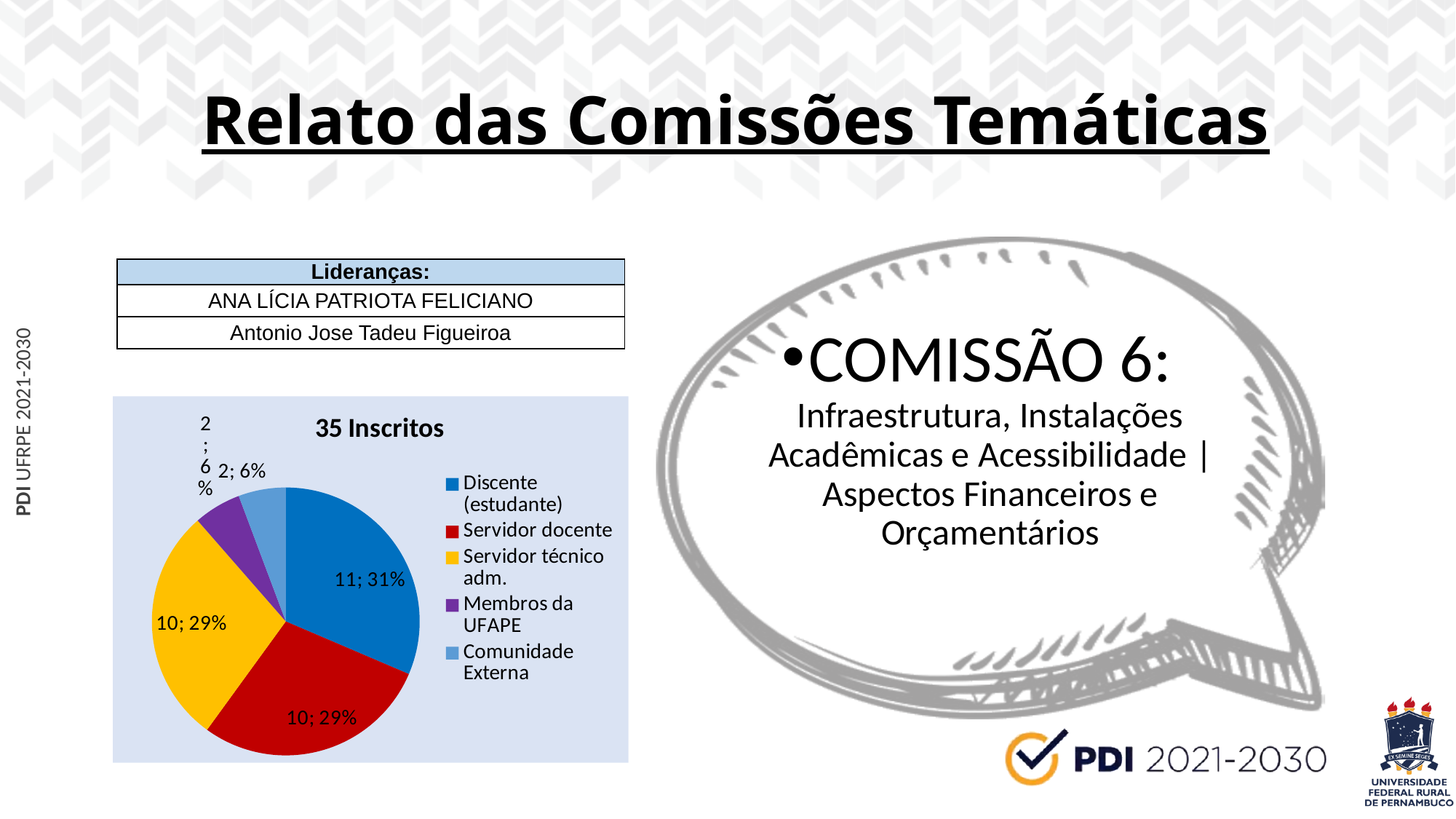
How many inscritos are in the Discente (estudante) category? 11 How many inscritos are in the Membros da UFAPE category? 2 What type of chart is shown on the slide? pie chart What percentage of the pie is Servidor técnico adm.? 29% What share of the pie does Comunidade Externa represent? 6% Which category has the largest slice of the pie? Discente (estudante) How many inscritos are in the Servidor docente category? 10 What share of the pie does Discente (estudante) represent? 31% What is the title of the pie chart? 35 Inscritos What is the difference in inscritos between Discente (estudante) and Servidor técnico adm.? 1 Which is larger, Discente (estudante) or Servidor docente? Discente (estudante) How many categories does the pie chart legend list? 5